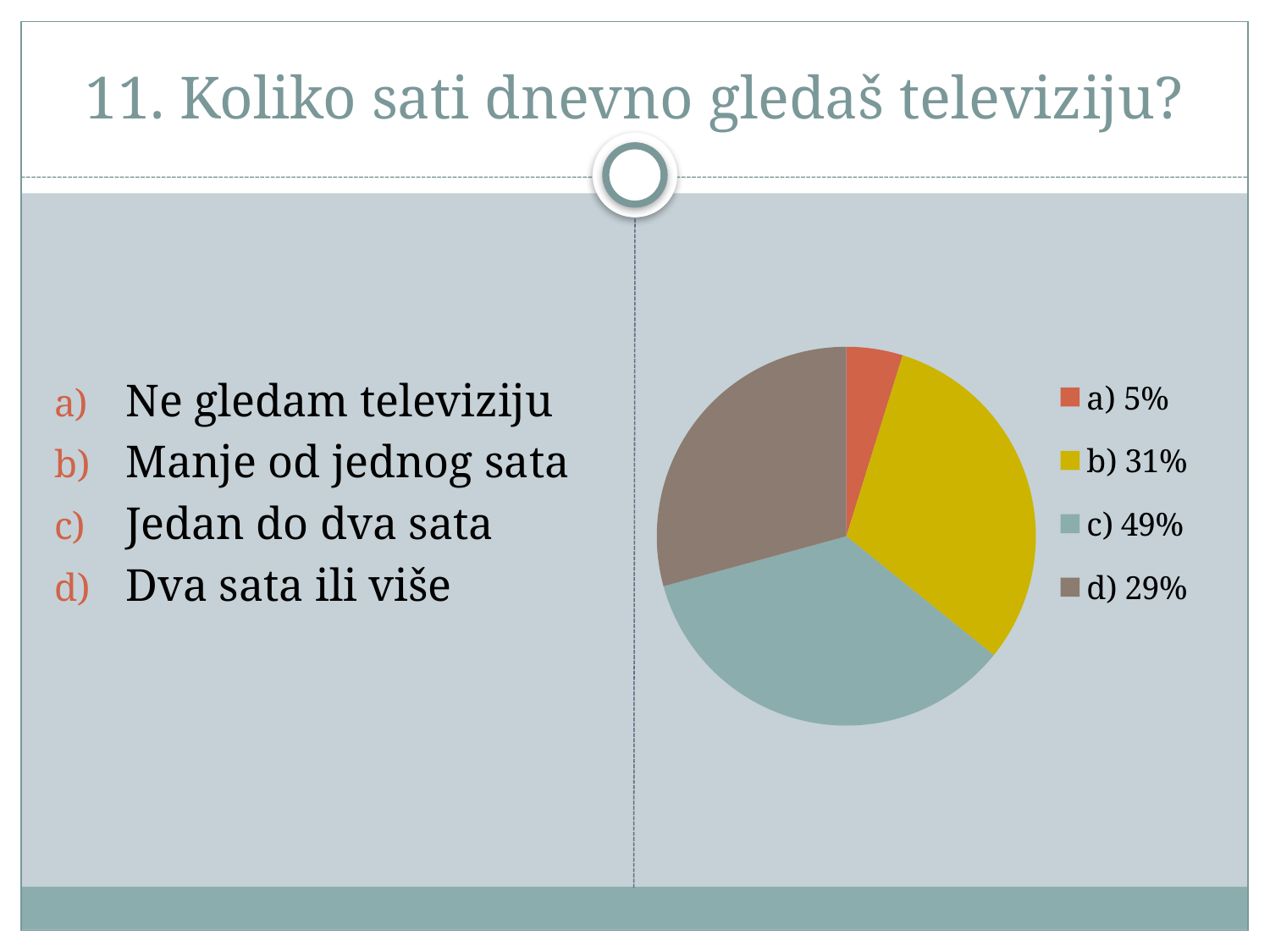
What percentage does the legend show for option b)? 31% What is the difference in percentage points between option c) and option b)? 18 Which option has the largest slice of the pie? c) How many slices does the pie chart have? 4 Which option has the smallest slice of the pie? a) What kind of chart is shown on the slide? pie chart How many entries does the legend list? 4 What percentage does the legend show for option c)? 49% What percentage does the legend show for option a)? 5% What percentage does the legend show for option d)? 29% Which is larger, the slice for option b) or the slice for option d)? b) What colour is the slice for option c)? teal